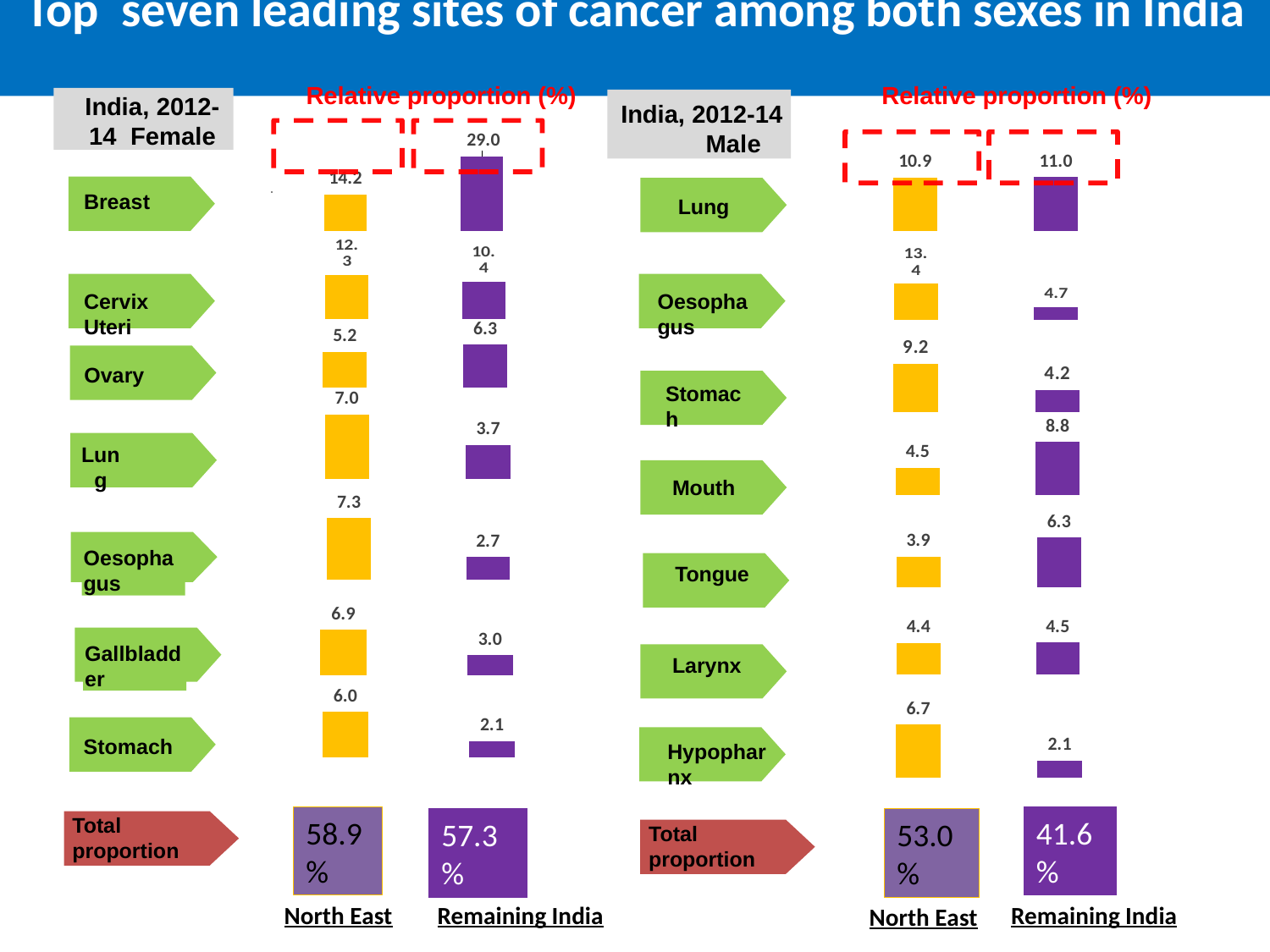
In the female chart, what is the relative proportion for Cervix Uteri in North East? 12.3 In the male chart, what is the total proportion for Remaining India? 41.6% How many cancer sites are listed in the female chart? 7 How many series (regions) are shown for each cancer site in the male chart? 2 In the female chart (India, 2012-14 Female), what is the relative proportion for Breast cancer in Remaining India? 29.0 What kind of chart is used to show the relative proportions on this slide? Bar chart In the male chart, what is the relative proportion for Mouth in Remaining India? 8.8 In the male chart, which cancer site has the highest relative proportion in North East? Oesophagus In the male chart (India, 2012-14 Male), what is the relative proportion for Oesophagus in North East? 13.4 In the female chart, which cancer site has the lowest relative proportion in Remaining India? Stomach In the male chart, which is larger for Stomach cancer: the North East value or the Remaining India value? North East In the female chart, what is the difference between the Remaining India and North East relative proportions for Breast cancer? 14.8